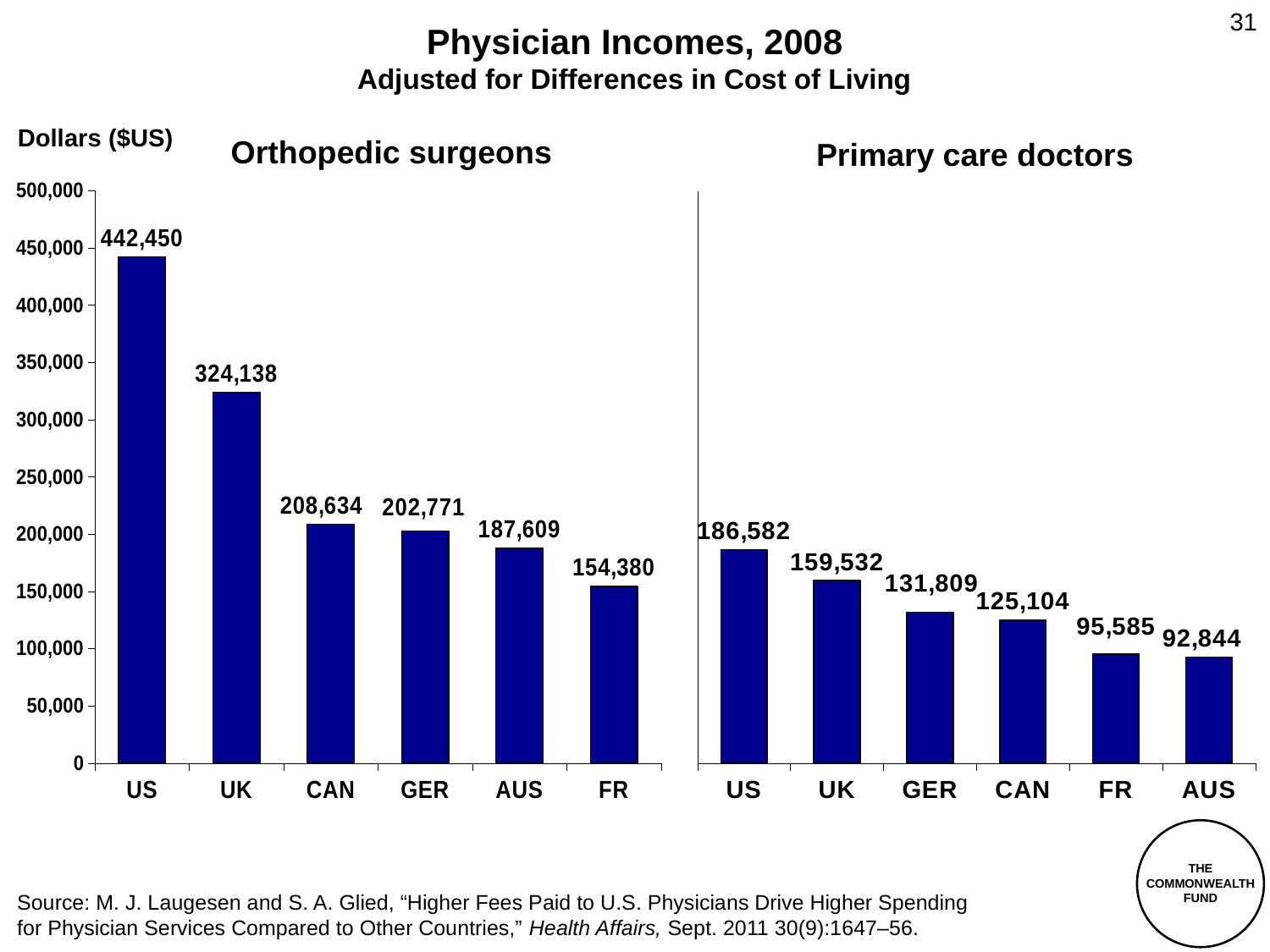
In the Orthopedic surgeons chart, what is the value for US? 442,450 In the Primary care doctors chart, which country has the highest value? US In the Orthopedic surgeons chart, what is the difference between the US and UK values? 118,312 In the Primary care doctors chart, what is the value for GER? 131,809 How many countries are shown in the Orthopedic surgeons chart? 6 What kind of chart is the Primary care doctors chart? bar chart In the Orthopedic surgeons chart, which is larger, the value for CAN or the value for GER? CAN In the Primary care doctors chart, do the values rise or fall from left to right? fall What unit is shown on the y axis label of the charts? Dollars ($US) In the Orthopedic surgeons chart, which country has the lowest value? FR In the Primary care doctors chart, is the value for UK greater or less than 150,000? greater In the Primary care doctors chart, what is the difference between the FR and AUS values? 2,741